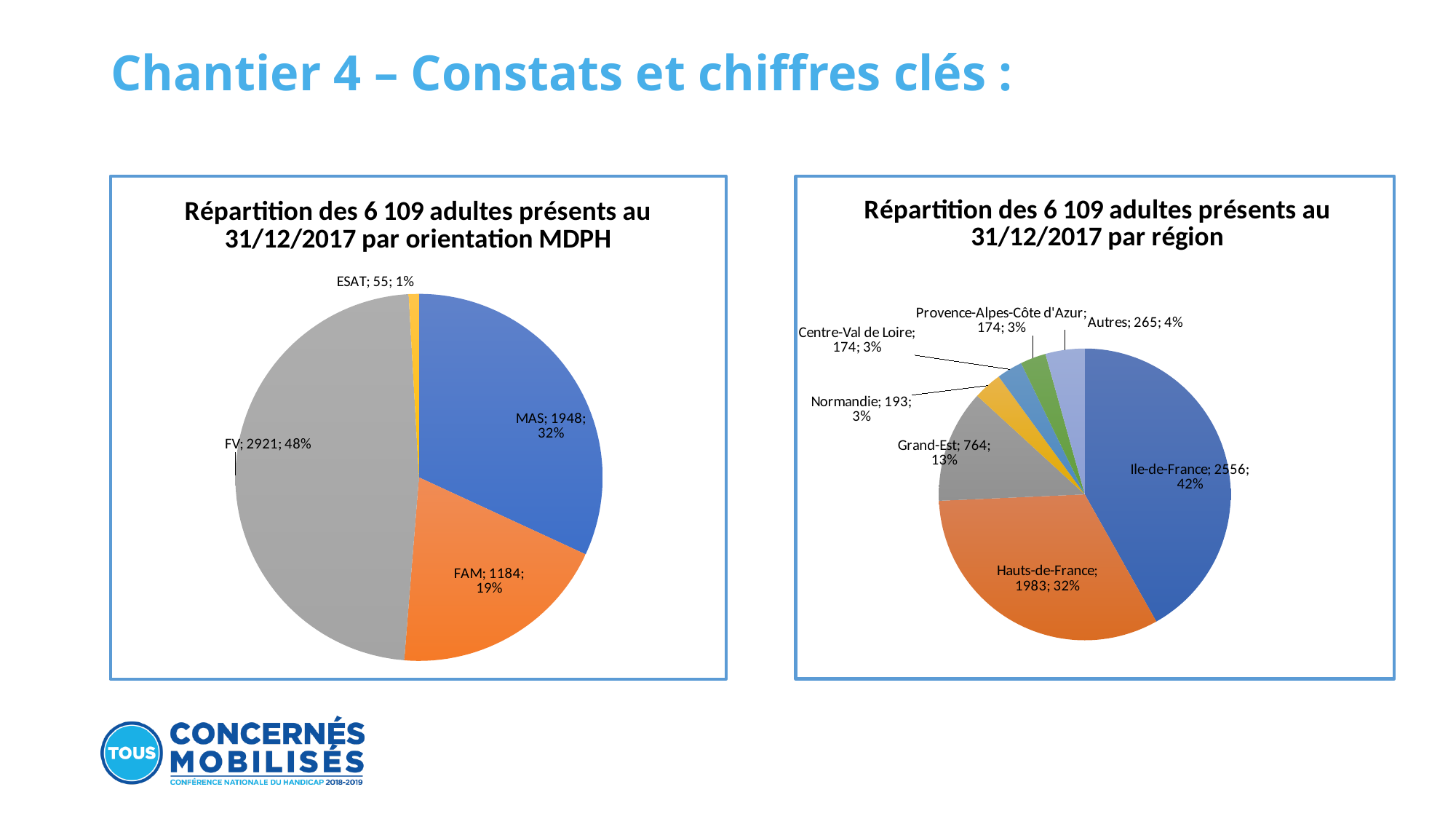
In the left chart (par orientation MDPH), which orientation has the largest slice? FV In the right chart (par région), what share of the pie does Ile-de-France represent? 42% In the left chart (par orientation MDPH), how many adults have the FV orientation? 2921 In the left chart (par orientation MDPH), which orientation has the smallest slice? ESAT In the left chart (par orientation MDPH), what share of the pie does MAS represent? 32% In the right chart (par région), how many adults are in Hauts-de-France? 1983 In the right chart (par région), which is larger, Grand-Est or Autres? Grand-Est In the left chart (par orientation MDPH), what is the difference between the MAS and FAM counts? 764 In the right chart (par région), which region has the largest slice? Ile-de-France In the left chart (par orientation MDPH), how many slices does the pie have? 4 In the right chart (par région), what is the difference between the Ile-de-France and Hauts-de-France counts? 573 What type of chart is used on the right side of the slide (par région)? Pie chart